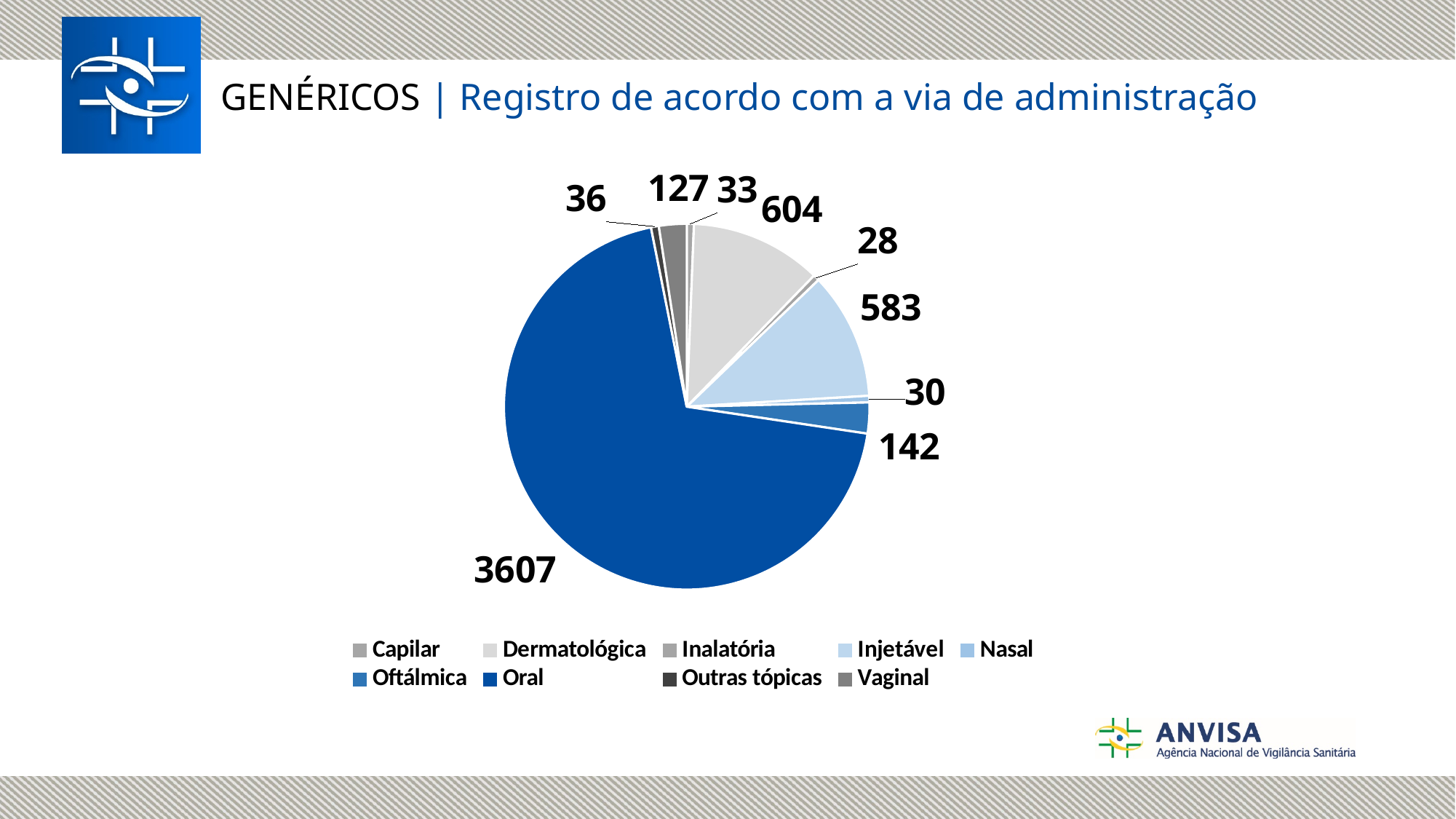
Which route of administration has the smallest value in the pie chart? Inalatória How many categories (routes of administration) does the pie chart show? 9 Which is larger, the value for Dermatológica or the value for Injetável? Dermatológica What is the difference between the values for Dermatológica and Injetável? 21 What is the title of the slide containing the pie chart? GENÉRICOS | Registro de acordo com a via de administração What is the value shown for Oftálmica? 142 What is the value shown for Inalatória? 28 What is the value shown for Oral? 3607 What is the value shown for Injetável? 583 Which route of administration has the largest slice of the pie? Oral What is the value shown for Dermatológica? 604 What kind of chart is shown on the slide? pie chart